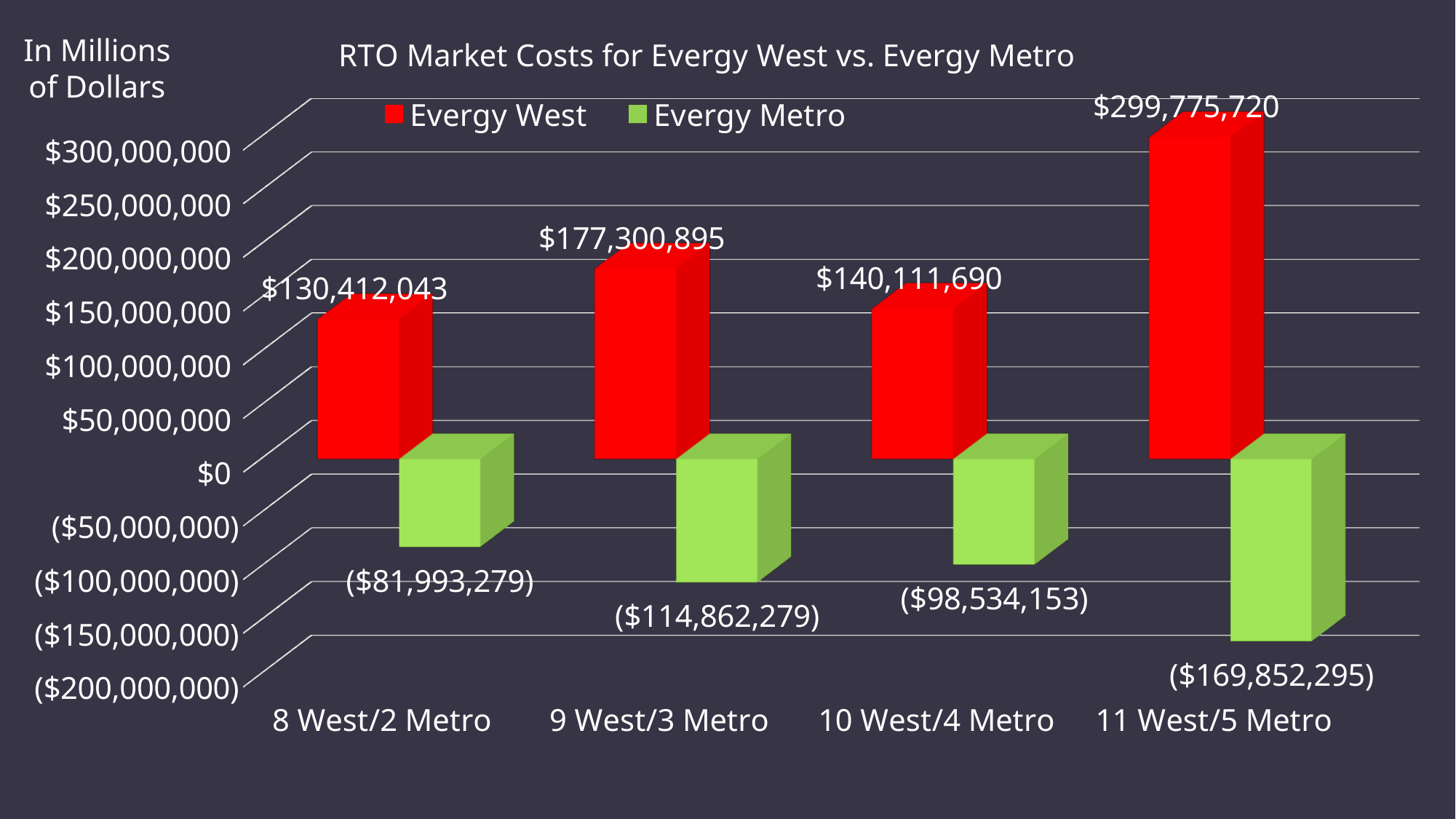
What is the difference between the Evergy West values for 11 West/5 Metro and 8 West/2 Metro? $169,363,677 What is the Evergy Metro value for 9 West/3 Metro? ($114,862,279) What is the Evergy Metro value for 10 West/4 Metro? ($98,534,153) What is the Evergy West value for 11 West/5 Metro? $299,775,720 Which is larger for Evergy West: 9 West/3 Metro or 10 West/4 Metro? 9 West/3 Metro What is the title of the chart? RTO Market Costs for Evergy West vs. Evergy Metro Which category has the highest Evergy West value? 11 West/5 Metro How many series does the legend list? 2 What is the Evergy West value for 8 West/2 Metro? $130,412,043 What kind of chart is shown? Bar chart Which category has the lowest Evergy West value? 8 West/2 Metro How many categories are shown on the x axis? 4